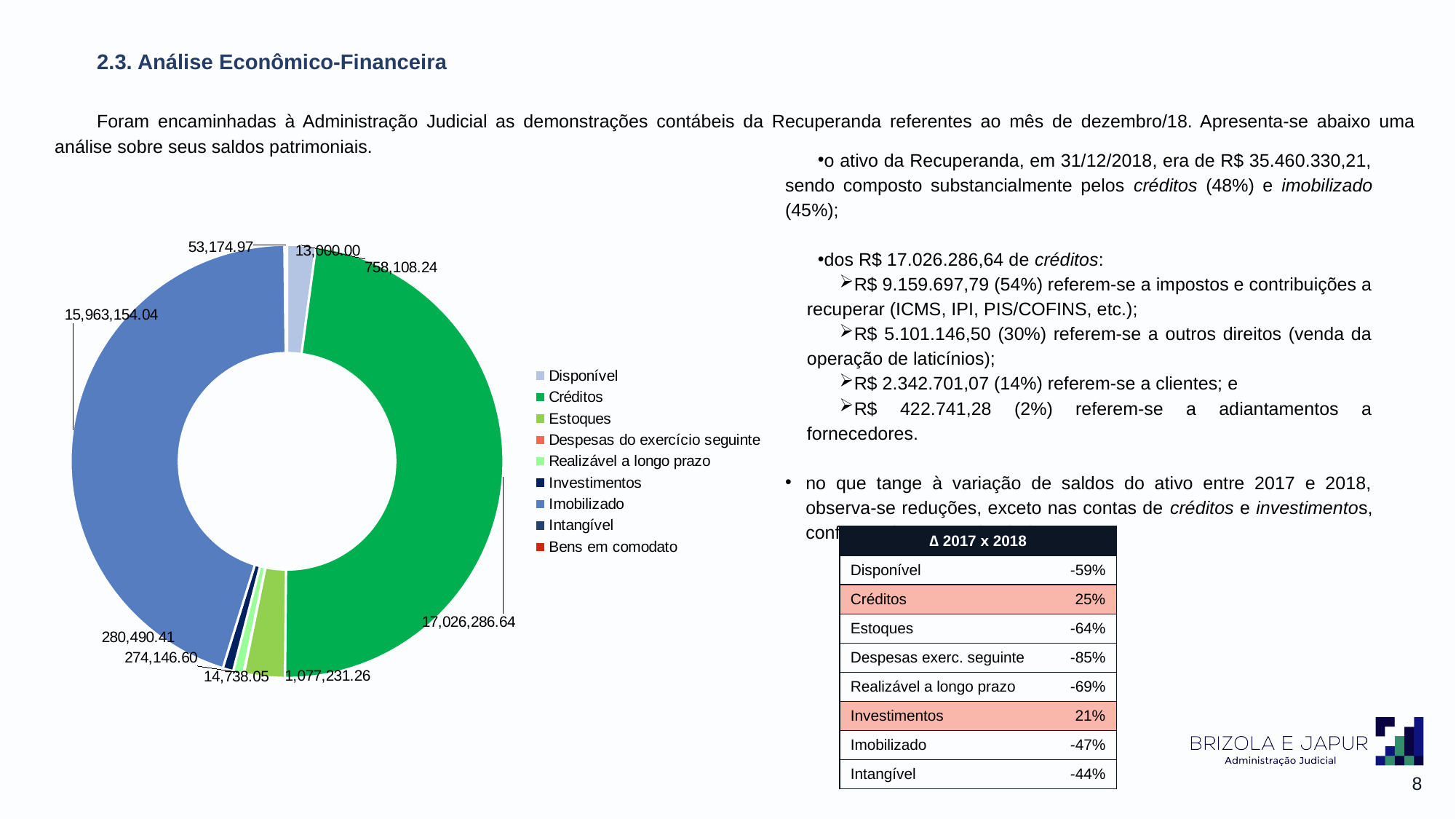
What is the value shown for Bens em comodato in the chart? 13,000.00 What is the difference between the values for Créditos and Imobilizado in the chart? 1,063,132.60 What is the value shown for Estoques in the chart? 1,077,231.26 What is the value shown for Disponível in the chart? 758,108.24 What kind of chart is shown on the slide? Pie (doughnut) chart Which category has the largest slice in the chart? Créditos Which is larger in the chart, Estoques or Disponível? Estoques Which category has the smallest value in the chart? Bens em comodato What is the value shown for Imobilizado in the chart? 15,963,154.04 What is the value shown for Créditos in the chart? 17,026,286.64 How many categories does the legend of the chart list? 9 What is the value shown for Intangível in the chart? 53,174.97